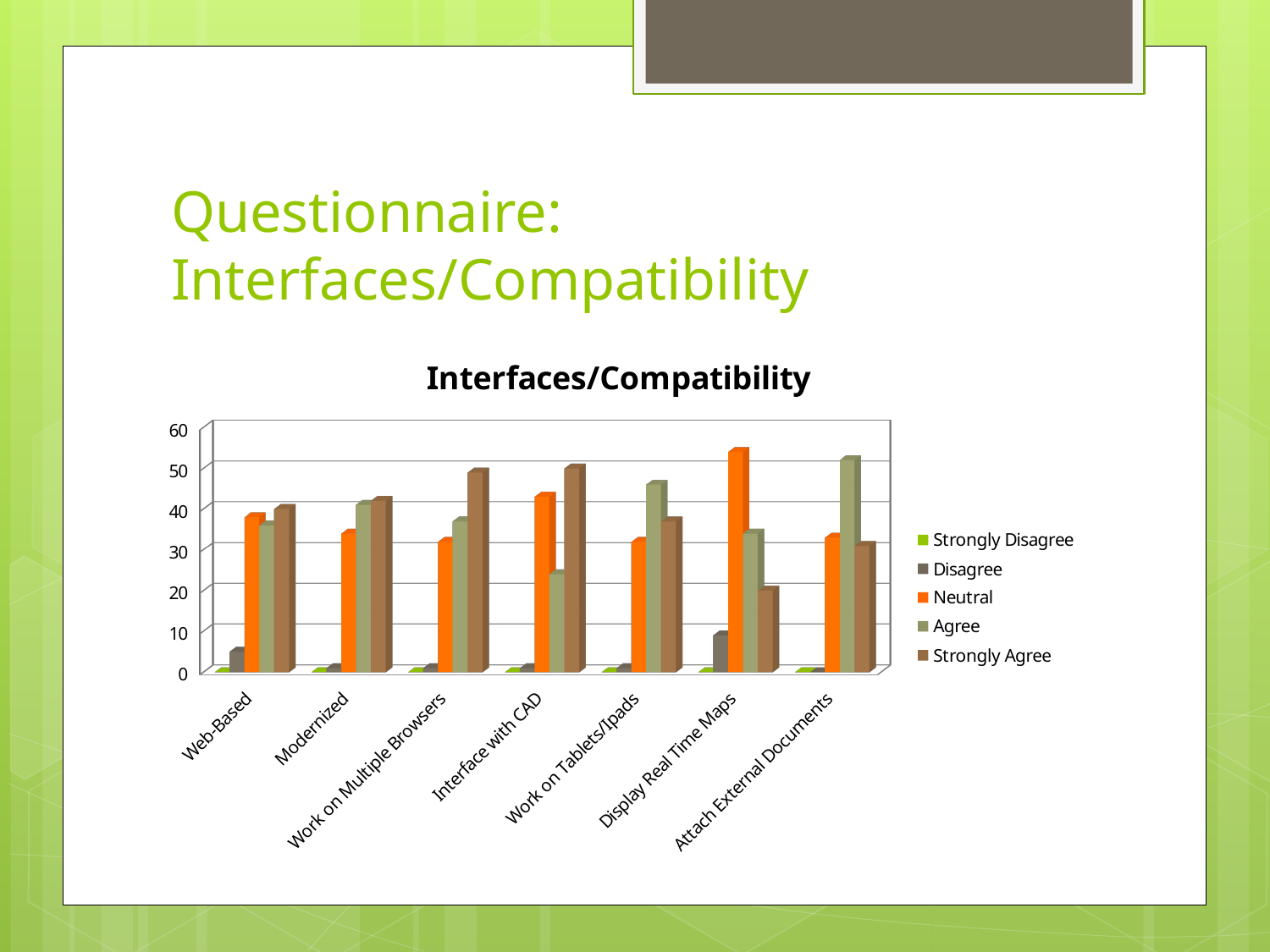
For Interface with CAD, which is larger: the Neutral value or the Agree value? Neutral Which category has the lowest Strongly Agree value? Display Real Time Maps What is the title of the chart? Interfaces/Compatibility How many categories are shown on the x axis of the chart? 7 Which category has the highest Neutral value? Display Real Time Maps Which series has the highest value for Interface with CAD? Strongly Agree Is the Agree value for Attach External Documents greater or less than 40? greater Is the Agree value for Interface with CAD greater or less than 30? less What kind of chart is shown on the slide? bar chart How many series does the legend list? 5 Is the Neutral value for Display Real Time Maps greater or less than 50? greater